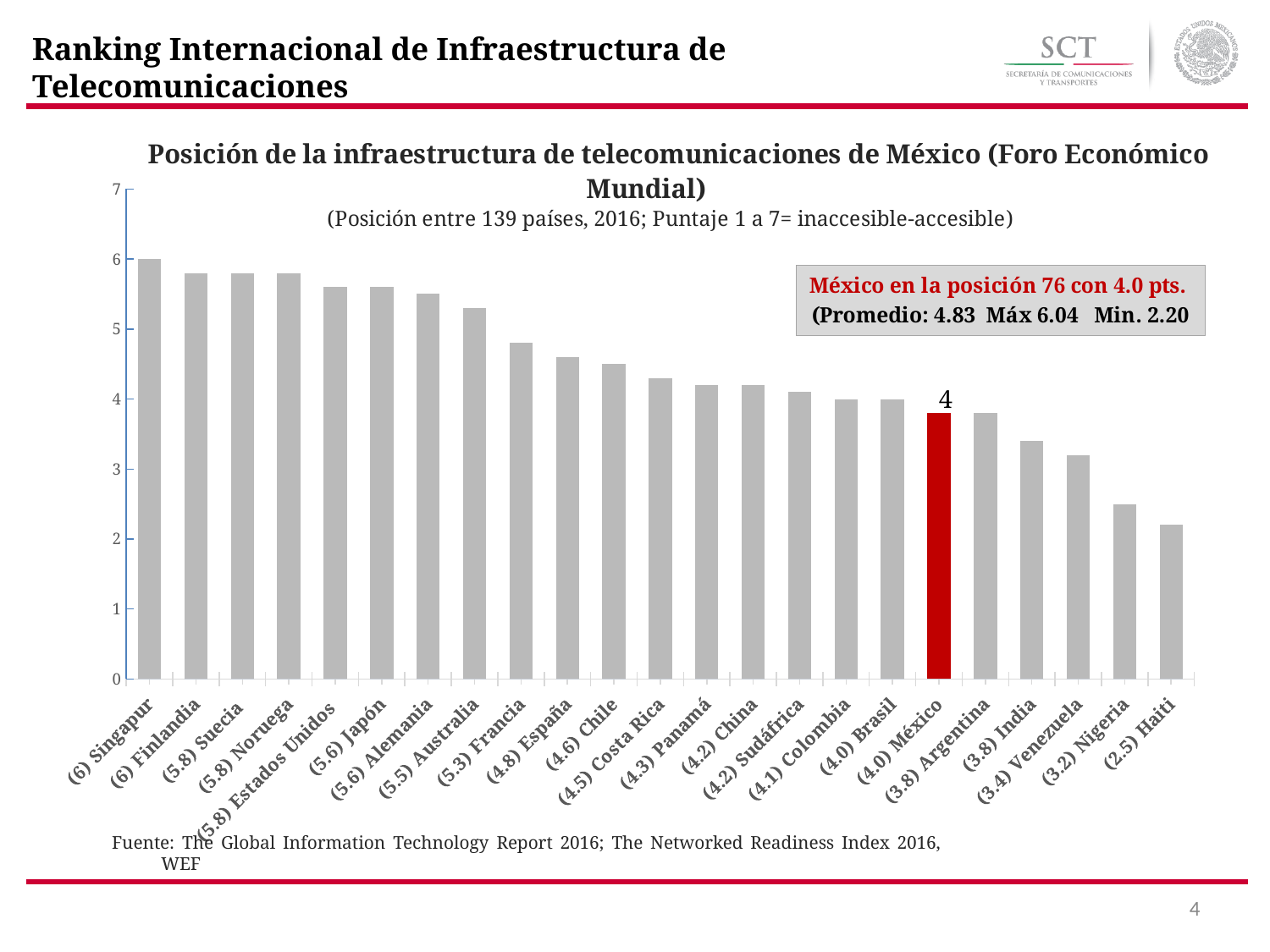
Which country has the highest bar in the chart? Singapur Which country has the lowest bar in the chart? Haití Which has a larger value, Singapur or Haití? Singapur What kind of chart is shown on the slide? bar chart How many countries are plotted in the chart? 23 Which country's bar is highlighted in red? México What value is printed as the data label on the bar for México? 4 Is the value for Singapur greater or less than 5? greater Is the value for Haití greater or less than 3? less Is the value for Nigeria greater or less than 3? less Do the bar values rise or fall from left to right along the x axis? fall According to the text box on the chart, what position does México hold? 76